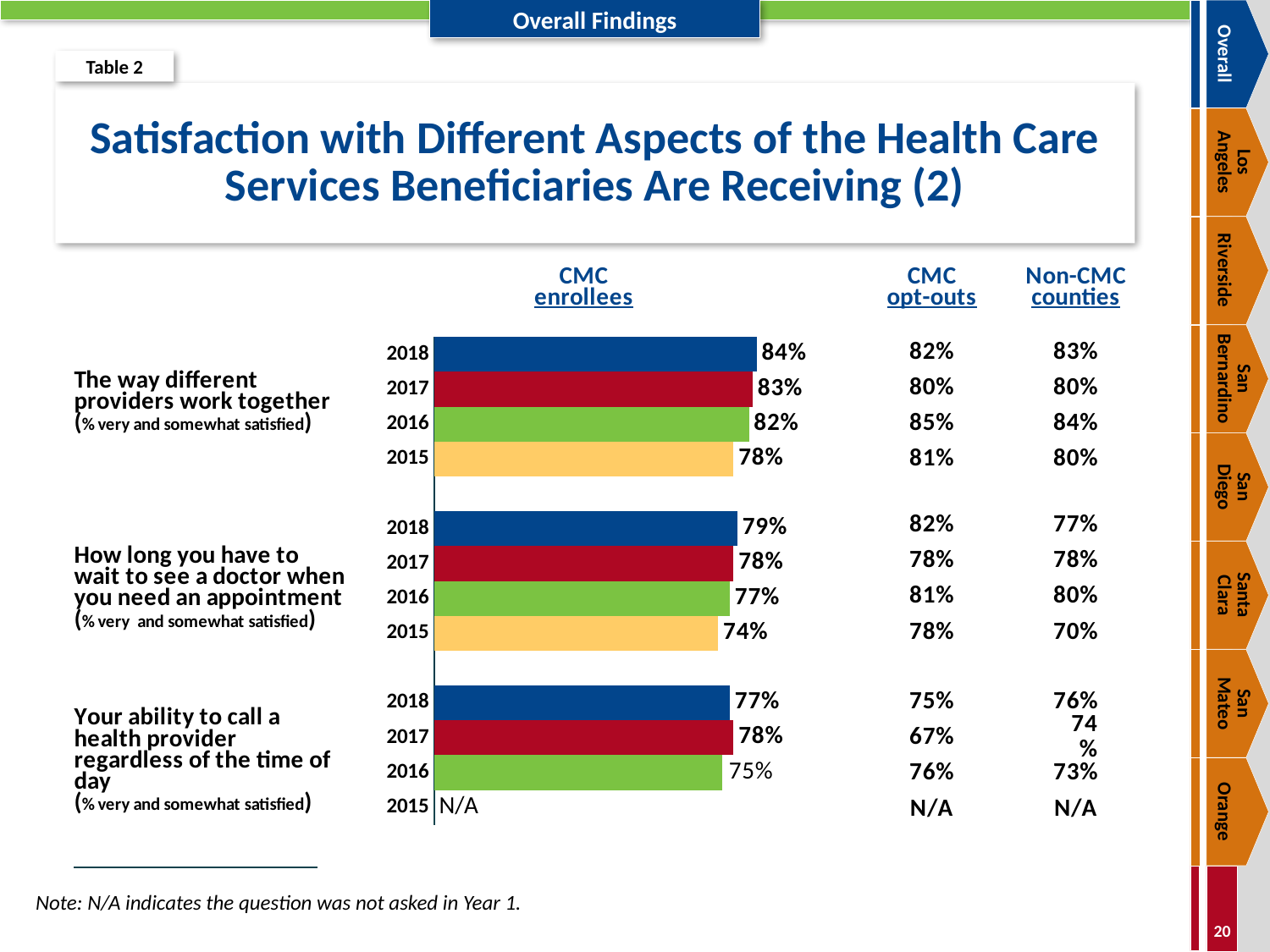
What type of chart is used to show the CMC enrollees values on this slide? bar chart In the bar chart for 'How long you have to wait to see a doctor when you need an appointment', which year has the lowest CMC enrollees value? 2015 In the bar chart for 'The way different providers work together', what is the CMC enrollees value for 2018? 84% In the bar chart for 'The way different providers work together', which year has the highest CMC enrollees value? 2018 In the bar chart for 'How long you have to wait to see a doctor when you need an appointment', do the CMC enrollees values rise or fall from 2015 to 2018? rise In the bar chart for 'Your ability to call a health provider regardless of the time of day', what is shown for CMC enrollees in 2015? N/A In the bar chart for 'The way different providers work together', what is the difference between the 2018 and 2015 CMC enrollees values? 6 percentage points In the bar chart for 'The way different providers work together', what is the CMC enrollees value for 2015? 78% In the bar chart for 'Your ability to call a health provider regardless of the time of day', which is larger for CMC enrollees: 2017 or 2018? 2017 In the bar chart for 'How long you have to wait to see a doctor when you need an appointment', what is the CMC enrollees value for 2017? 78% In the bar chart for 'Your ability to call a health provider regardless of the time of day', what is the CMC enrollees value for 2016? 75% How many bars are plotted in the bar chart for 'The way different providers work together'? 4